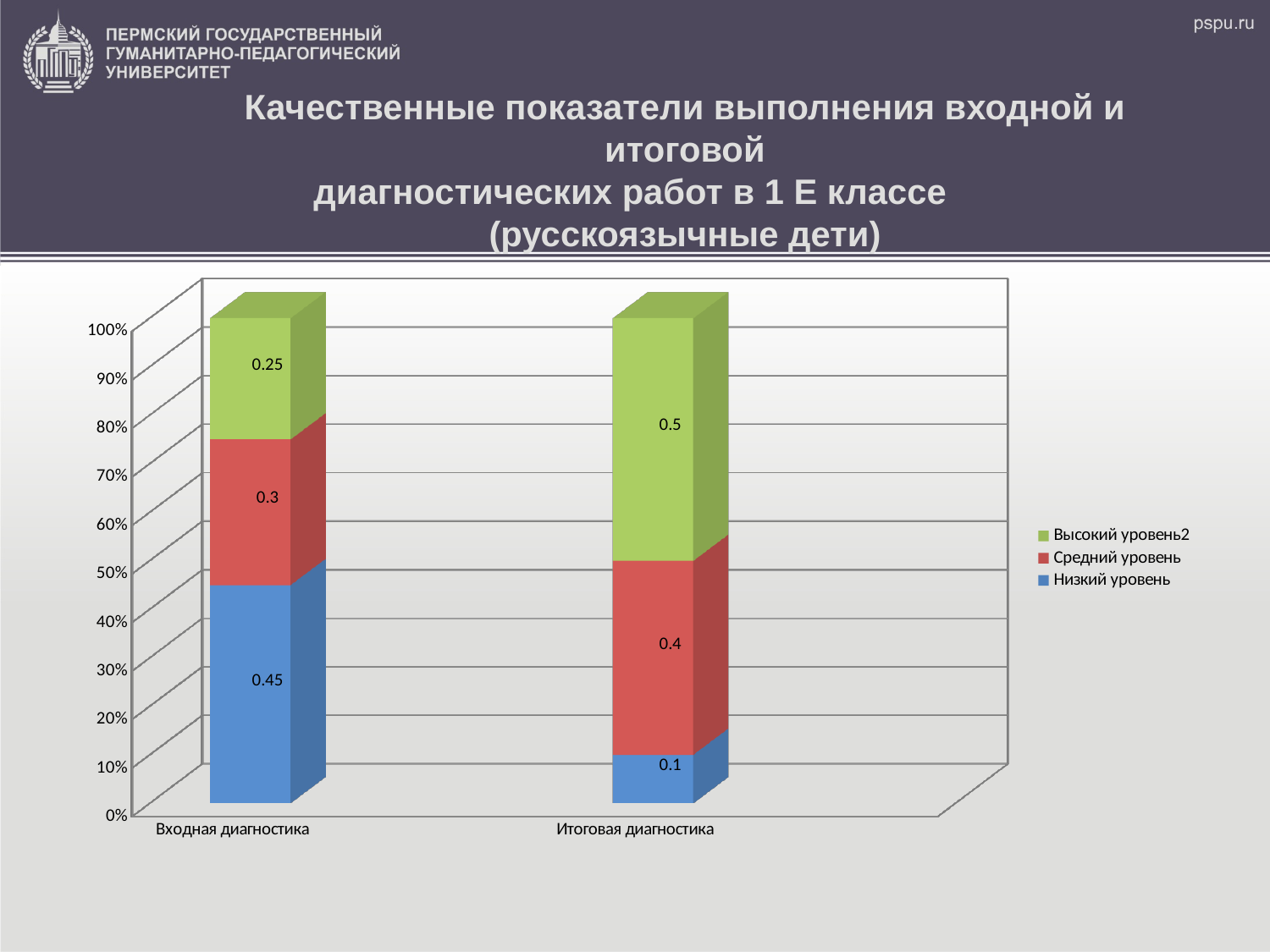
What is the difference between the Высокий уровень2 values for Итоговая диагностика and Входная диагностика? 0.25 Which category has the higher value for Низкий уровень? Входная диагностика What is the value of Высокий уровень2 for Входная диагностика? 0.25 What is the difference between the Низкий уровень values for Входная диагностика and Итоговая диагностика? 0.35 How many series does the legend list? 3 What is the value of Низкий уровень for Итоговая диагностика? 0.1 What is the value of Низкий уровень for Входная диагностика? 0.45 What is the value of Высокий уровень2 for Итоговая диагностика? 0.5 What is the value of Средний уровень for Итоговая диагностика? 0.4 What kind of chart is shown on the slide? Stacked bar chart How many categories are shown on the x axis? 2 Which series is shown in green in the legend? Высокий уровень2